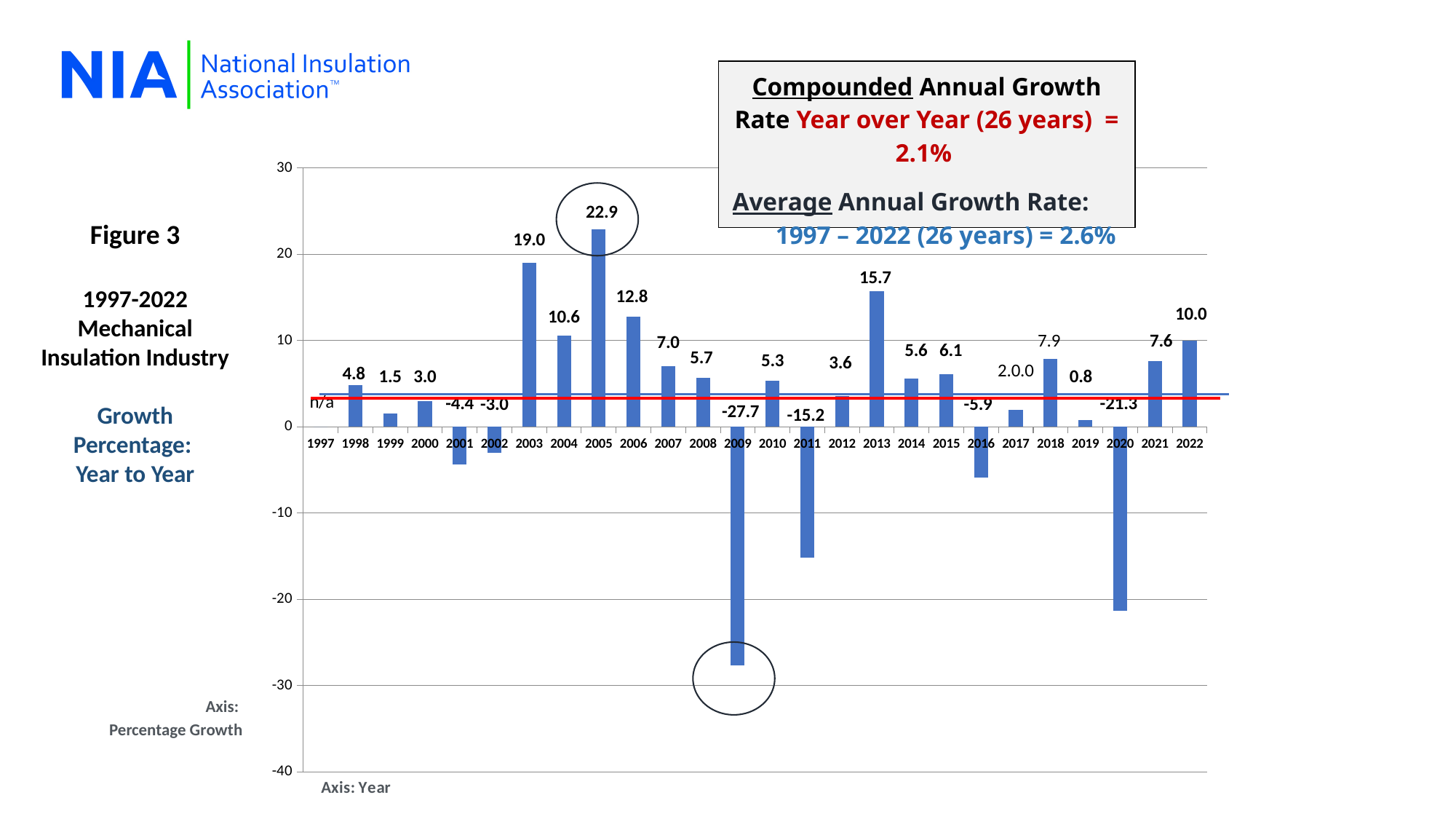
What is the difference between the growth percentage for 2003 and for 2004? 8.4 What is the growth percentage shown for 2009? -27.7 Which year has a larger growth percentage, 2013 or 2006? 2013 What is the growth percentage shown for 2005? 22.9 Is the value for 2020 greater or less than -20? less What kind of chart is shown on the slide? Bar chart Which year has the highest growth percentage? 2005 How many years are labelled on the x axis? 26 Which year has the lowest growth percentage? 2009 What is the growth percentage shown for 2022? 10.0 What value is shown for 1997? n/a What is the compounded annual growth rate year over year stated on the slide? 2.1%